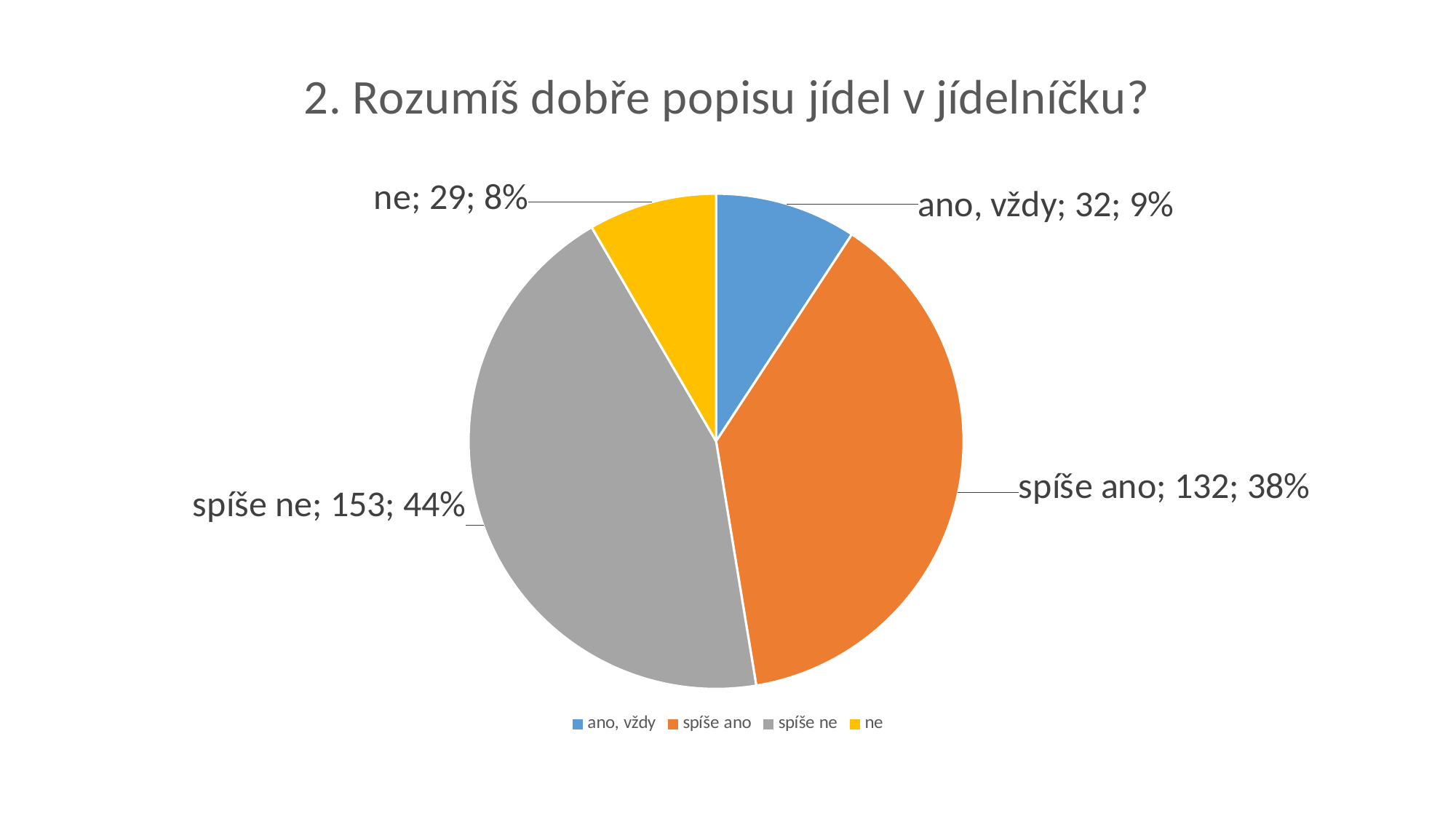
How many entries does the legend list? 4 Which category has the largest slice? spíše ne How many slices does the pie chart have? 4 What is the count for "spíše ne"? 153 What is the title of the chart? 2. Rozumíš dobře popisu jídel v jídelníčku? What is the count for "ano, vždy"? 32 What percentage share does "ne" have? 8% Which is larger, the count for "ano, vždy" or the count for "ne"? ano, vždy What is the difference in count between "spíše ne" and "spíše ano"? 21 Which category has the smallest slice? ne What kind of chart is shown on the slide? pie chart What percentage share does "spíše ano" have? 38%